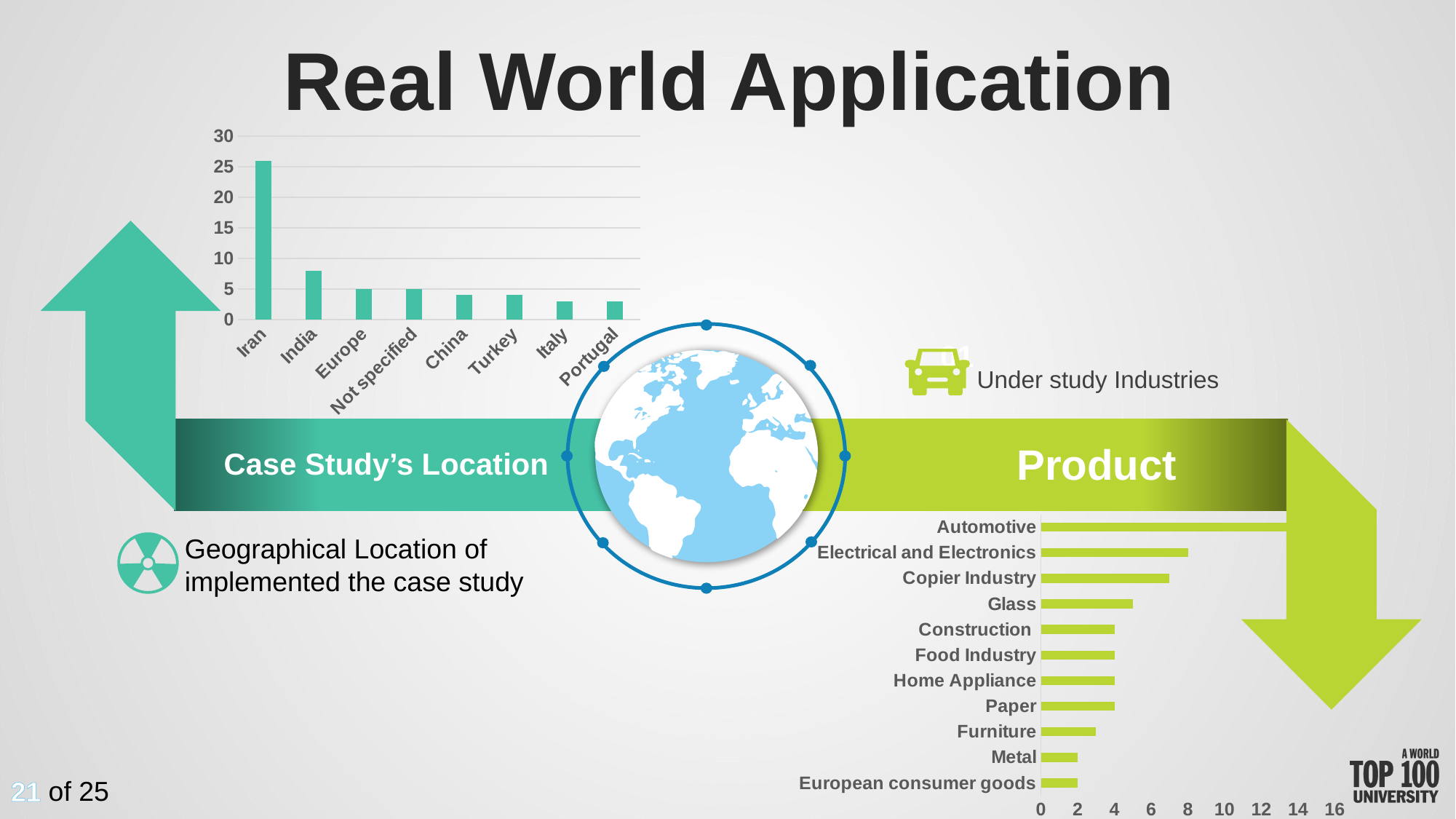
In the "Case Study's Location" chart, which category has the highest value? Iran How many categories are shown in the "Case Study's Location" chart? 8 In the "Product" chart, which is larger, the value for Glass or the value for Metal? Glass How many industries are listed in the "Product" chart? 11 In the "Case Study's Location" chart, is the value for India greater or less than 10? less In the "Case Study's Location" chart, which is larger, the value for Iran or the value for India? Iran In the "Product" chart, which industry has the highest value? Automotive What kind of chart is the chart under the "Product" heading? bar chart In the "Product" chart, is the value for Automotive greater or less than 12? greater What kind of chart is the chart under the "Case Study's Location" heading? bar chart In the "Case Study's Location" chart, do the values generally rise or fall from left to right along the x axis? fall In the "Case Study's Location" chart, is the value for Iran greater or less than 25? greater